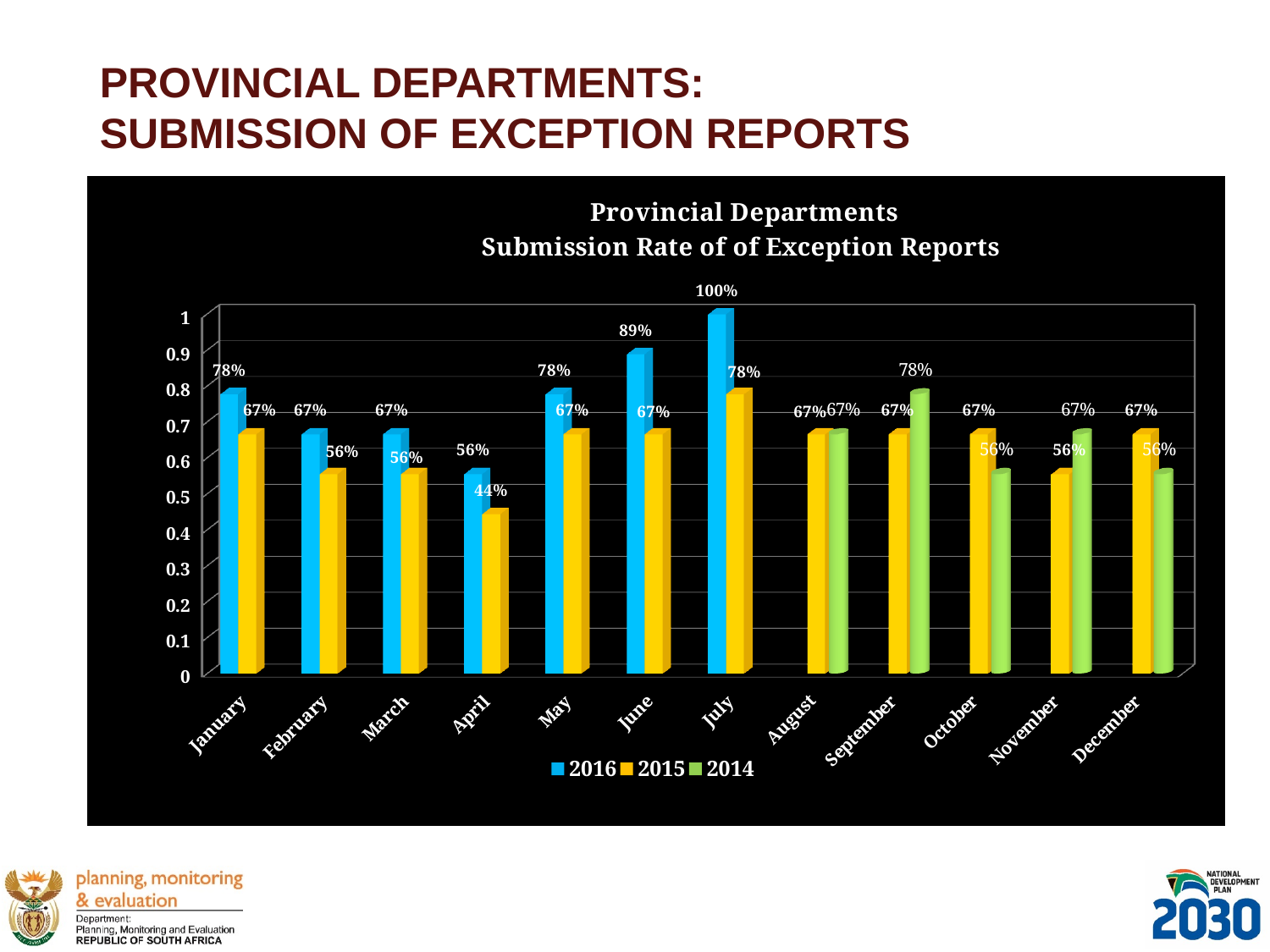
What is the 2015 submission rate for April? 44% What is the 2014 submission rate for September? 78% Which colour represents the 2014 series in the legend? Green Which month has the lowest 2015 submission rate? April What is the 2016 submission rate for June? 89% What kind of chart is shown on the slide? Bar chart How many series does the legend list? 3 How many months are shown on the x axis? 12 What is the difference between the 2016 and 2015 submission rates for June? 22% Which month has the highest 2016 submission rate? July Which is larger for November: the 2015 rate or the 2014 rate? 2014 What is the 2016 submission rate for July? 100%